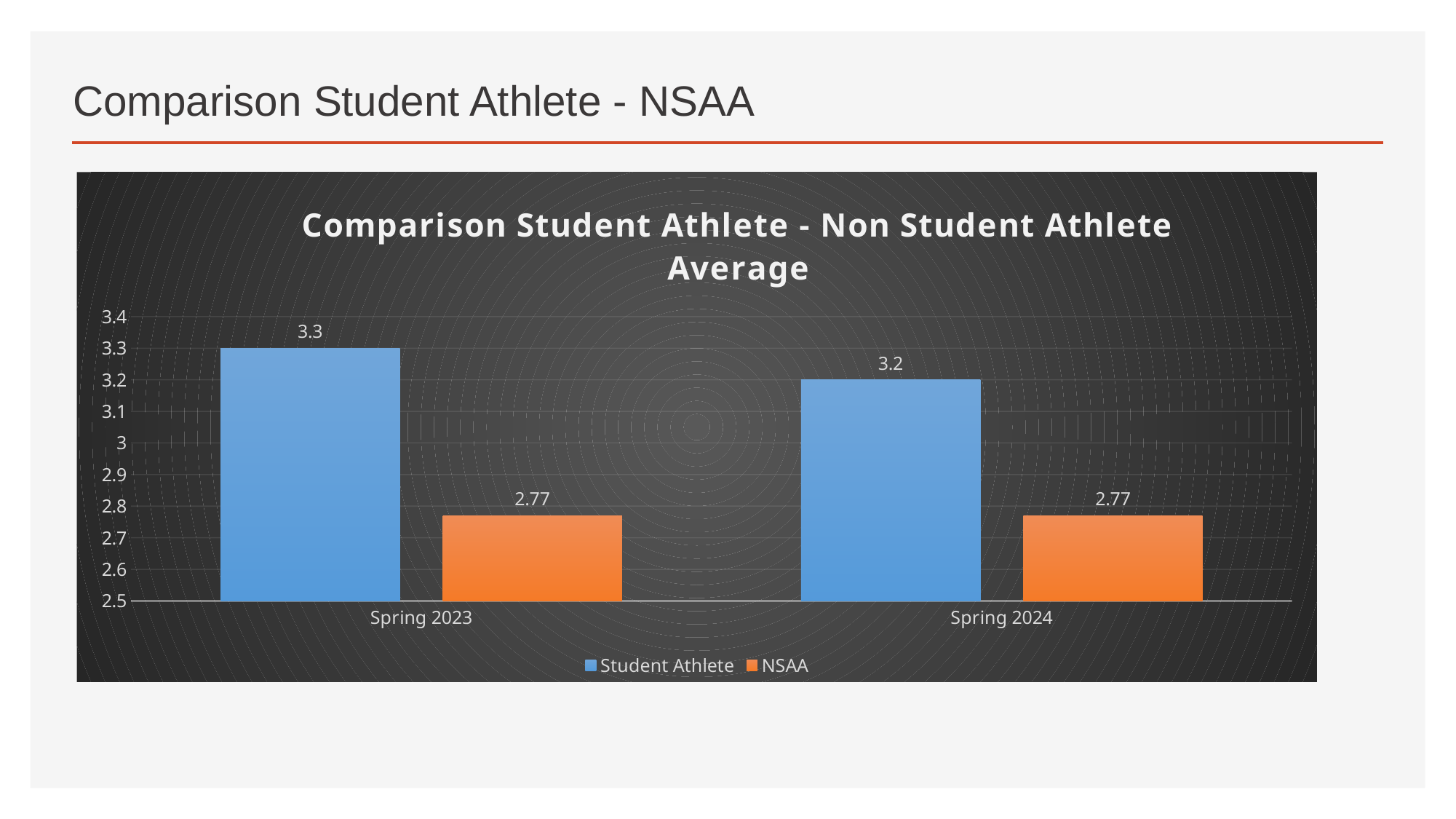
How many categories are shown on the x axis? 2 What is the title of the chart? Comparison Student Athlete - Non Student Athlete Average Does the Student Athlete value rise or fall from Spring 2023 to Spring 2024? fall What is the Student Athlete value for Spring 2024? 3.2 Which category has the highest Student Athlete value? Spring 2023 What is the difference between the Student Athlete and NSAA values in Spring 2023? 0.53 What is the NSAA value for Spring 2024? 2.77 What is the Student Athlete value for Spring 2023? 3.3 How many series does the legend list? 2 What is the difference between the Student Athlete and NSAA values in Spring 2024? 0.43 Which series has the higher value in Spring 2023, Student Athlete or NSAA? Student Athlete What kind of chart is shown on the slide? bar chart